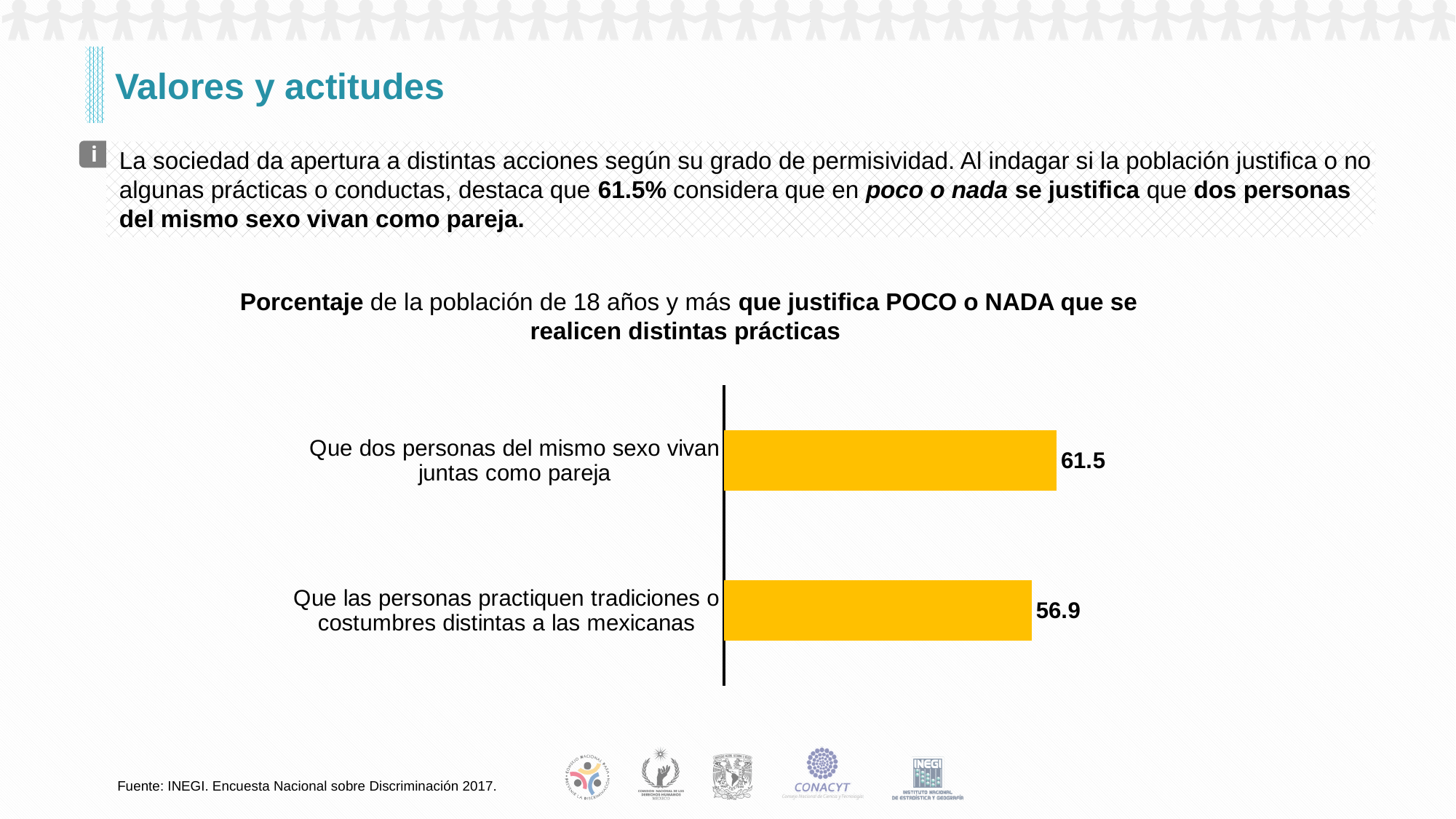
Which category has the highest value? Que dos personas del mismo sexo vivan juntas como pareja What kind of chart is shown on the slide? Bar chart Which is larger: the value for 'Que dos personas del mismo sexo vivan juntas como pareja' or the value for 'Que las personas practiquen tradiciones o costumbres distintas a las mexicanas'? Que dos personas del mismo sexo vivan juntas como pareja What is the value for 'Que las personas practiquen tradiciones o costumbres distintas a las mexicanas'? 56.9 What is the source cited for the chart? INEGI. Encuesta Nacional sobre Discriminación 2017. What colour are the bars in the chart? Yellow What is the value for 'Que dos personas del mismo sexo vivan juntas como pareja'? 61.5 Which category has the lowest value? Que las personas practiquen tradiciones o costumbres distintas a las mexicanas What is the title of the chart? Porcentaje de la población de 18 años y más que justifica POCO o NADA que se realicen distintas prácticas How many categories are shown in the chart? 2 What is the difference between the value for 'Que dos personas del mismo sexo vivan juntas como pareja' and the value for 'Que las personas practiquen tradiciones o costumbres distintas a las mexicanas'? 4.6